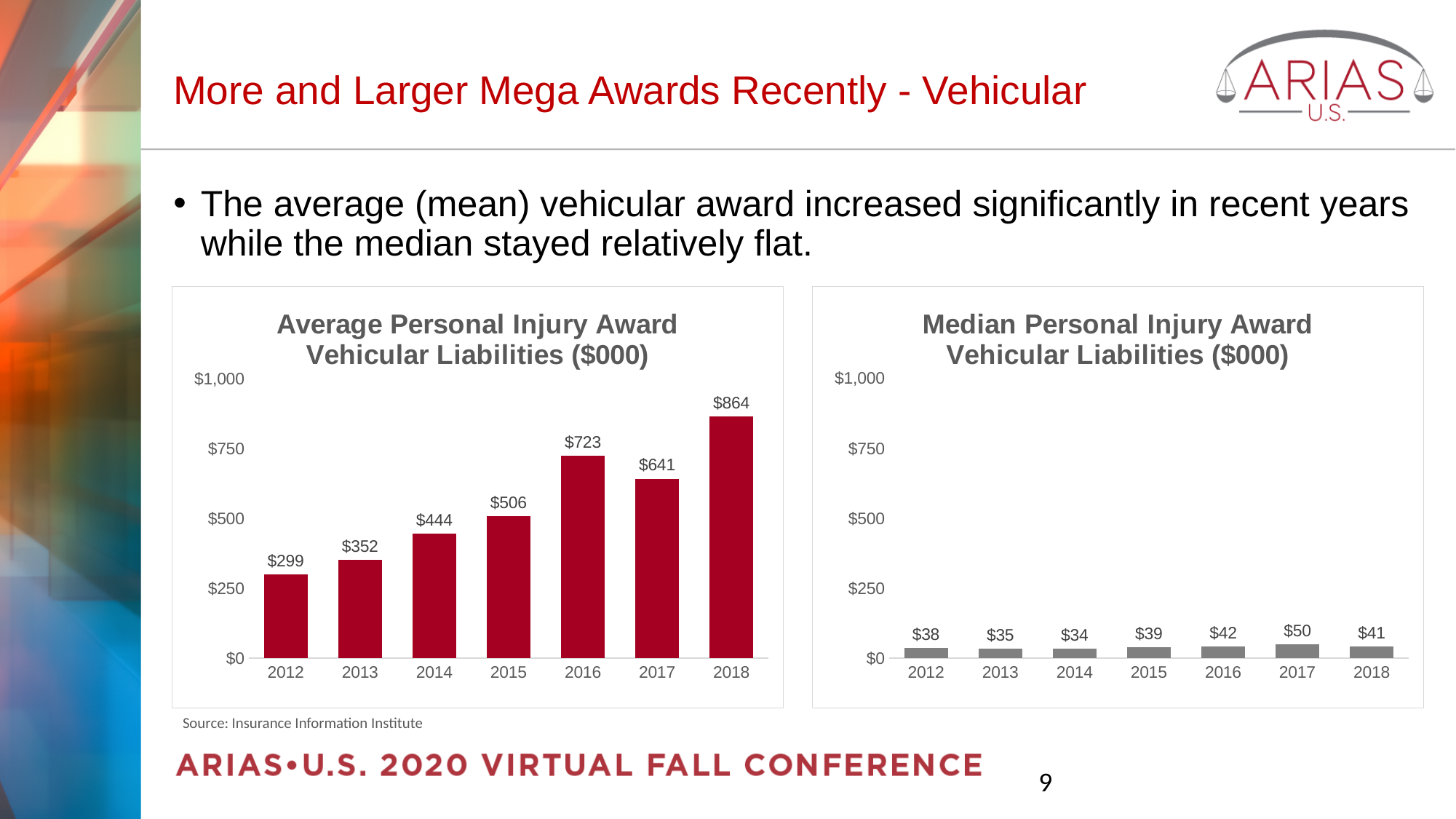
What kind of chart is the Average Personal Injury Award Vehicular Liabilities chart? Bar chart In the Average Personal Injury Award Vehicular Liabilities chart, what is the difference between the 2018 and 2012 values? $565 In the Average Personal Injury Award Vehicular Liabilities chart, is the value for 2015 greater or less than $500? greater In the Median Personal Injury Award Vehicular Liabilities chart, what is the value for 2017? $50 In the Median Personal Injury Award Vehicular Liabilities chart, which year has the lowest value? 2014 How many years are shown on the x axis of the Median Personal Injury Award Vehicular Liabilities chart? 7 In the Average Personal Injury Award Vehicular Liabilities chart, do the values generally rise or fall from 2012 to 2018? Rise In the Average Personal Injury Award Vehicular Liabilities chart, what is the value for 2016? $723 In the Median Personal Injury Award Vehicular Liabilities chart, what is the difference between the 2017 and 2013 values? $15 In the Average Personal Injury Award Vehicular Liabilities chart, which is larger, the value for 2016 or the value for 2017? 2016 What is the title of the chart on the right side of the slide? Median Personal Injury Award Vehicular Liabilities ($000) In the Average Personal Injury Award Vehicular Liabilities chart, which year has the highest value? 2018